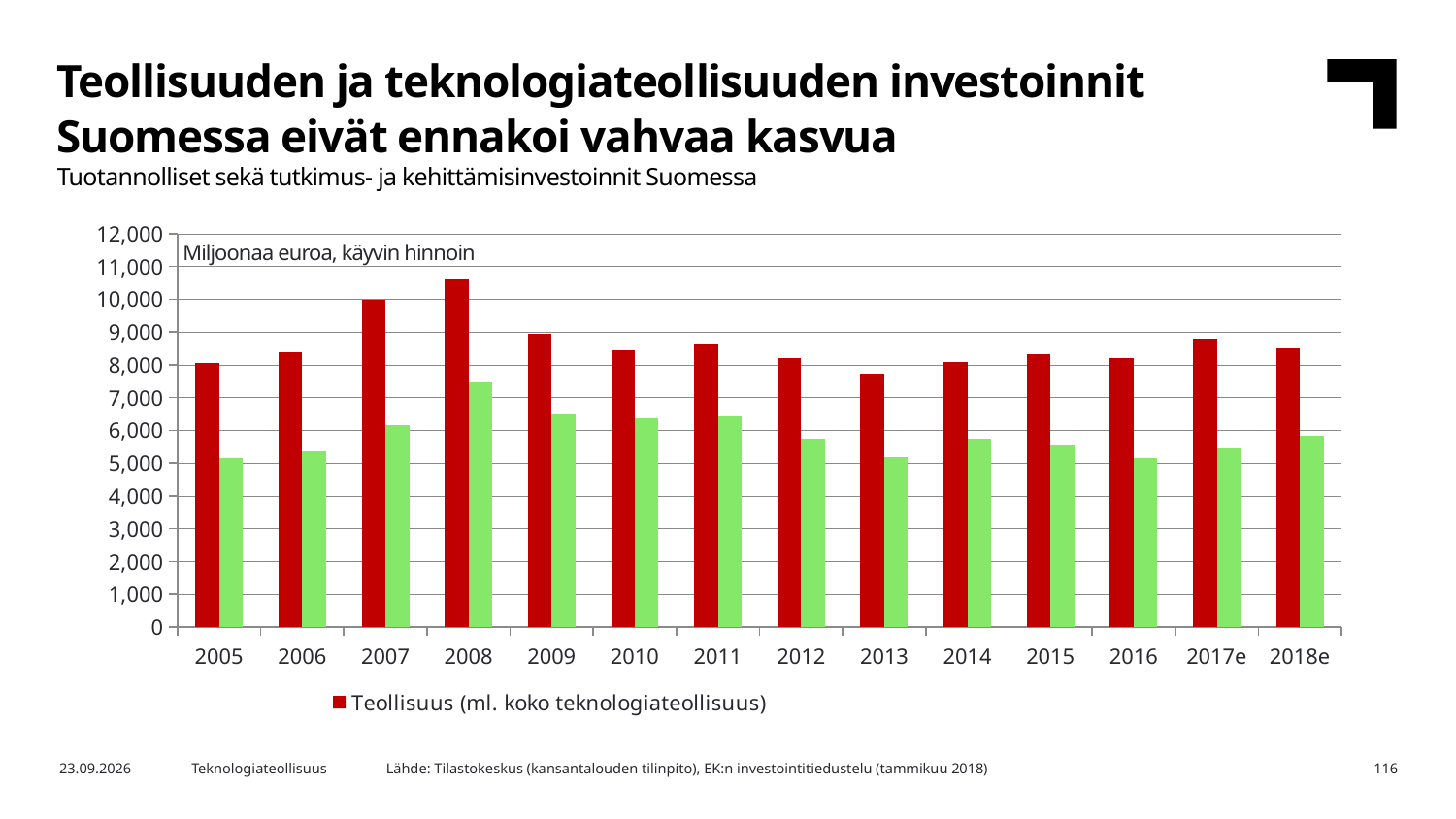
In which year is the red Teollisuus bar highest? 2008 In which year is the red Teollisuus bar lowest? 2013 Which year has the larger red Teollisuus bar, 2007 or 2008? 2008 Is the green bar value for 2008 greater or less than 7,000? greater What unit is stated in the text box inside the chart area? Miljoonaa euroa, käyvin hinnoin How many series does the legend list? 1 How many years (categories) are shown on the x axis? 14 Do the red Teollisuus bars rise or fall from 2005 to 2008? rise Is the red Teollisuus value for 2008 greater or less than 10,000? greater In which year is the green bar highest? 2008 What kind of chart is shown on the slide? bar chart Is the red Teollisuus value for 2013 greater or less than 8,000? less